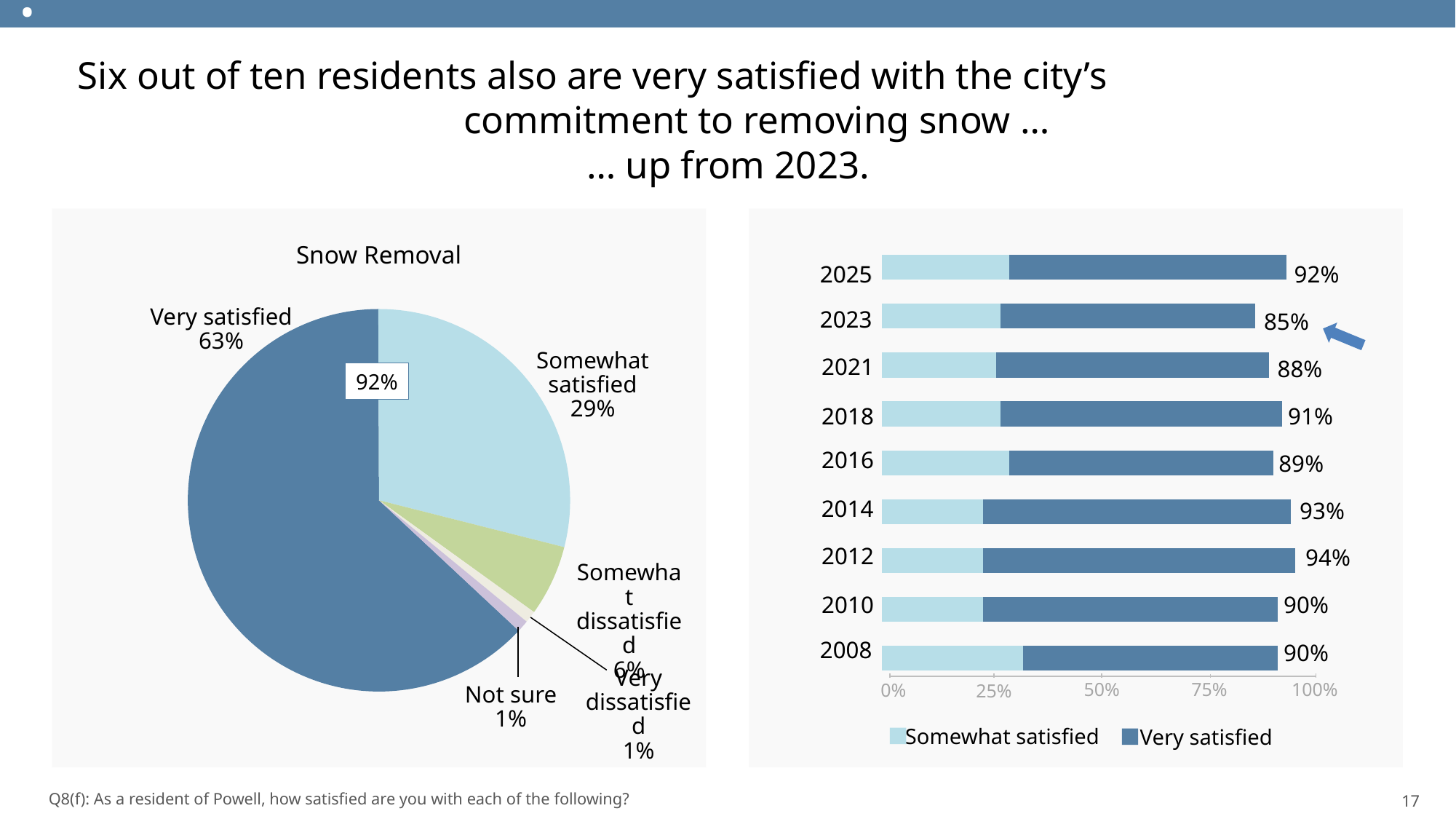
In the bar chart on the right, by how many percentage points does the 2025 total exceed the 2023 total? 7 percentage points In the bar chart on the right, which year has the lowest total satisfied percentage? 2023 What kind of chart is the Snow Removal chart on the left of the slide? Pie chart In the bar chart on the right, what is the total satisfied percentage for 2023? 85% How many series does the legend of the bar chart on the right list? 2 How many slices does the Snow Removal pie chart have? 5 In the Snow Removal pie chart, what percentage of residents are somewhat satisfied? 29% How many years are shown in the bar chart on the right? 9 In the bar chart on the right, which year has a higher total: 2018 or 2016? 2018 In the Snow Removal pie chart, which category has the largest slice? Very satisfied In the Snow Removal pie chart, what percentage of residents are very satisfied? 63% In the bar chart on the right, which year has the highest total satisfied percentage? 2012